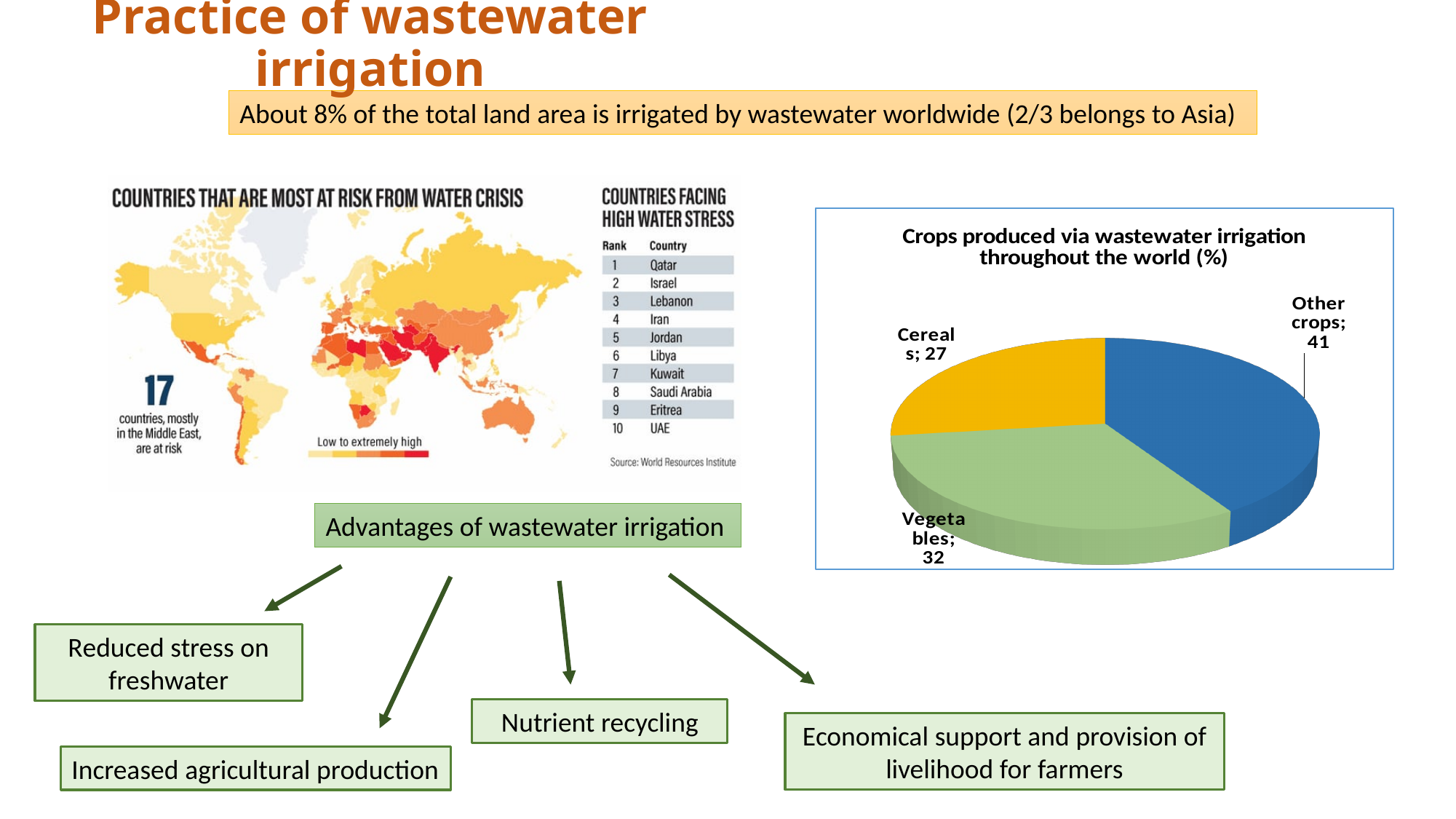
What is the difference between the values for Other crops and Cereals? 14 What is the title of the pie chart? Crops produced via wastewater irrigation throughout the world (%) What share of the pie does the Vegetables slice represent? 32% What is the value for Cereals in the pie chart? 27 How many categories are shown in the pie chart? 3 What is the difference between the values for Vegetables and Cereals? 5 What kind of chart is shown on the slide? pie chart Which category has the largest slice in the pie chart? Other crops What is the value for Other crops in the pie chart? 41 Which is larger, the value for Vegetables or the value for Other crops? Other crops What is the value for Vegetables in the pie chart? 32 Which category has the smallest slice in the pie chart? Cereals